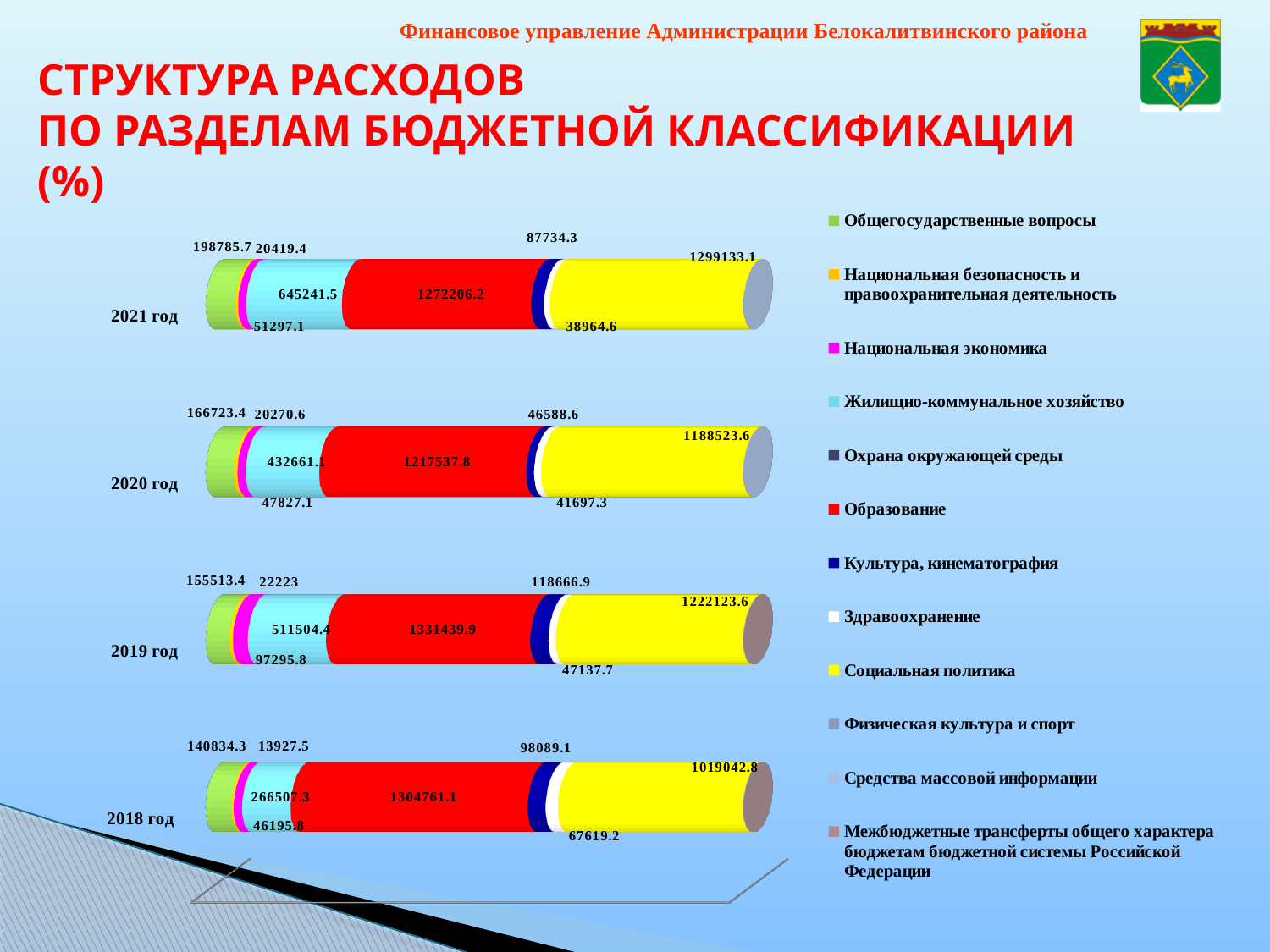
In which year is the Жилищно-коммунальное хозяйство (light blue) segment the lowest? 2018 год What is the value of the Жилищно-коммунальное хозяйство (light blue) segment for 2018 год? 266507.3 What is the value of the Образование (red) segment for 2021 год? 1272206.2 In which year is the Образование (red) segment the highest? 2019 год What is the value of the Образование (red) segment for 2018 год? 1304761.1 How many years (bars) are shown in the chart? 4 Which year has the larger Образование value, 2019 год or 2020 год? 2019 год What kind of chart is shown on the slide? Stacked bar chart How many series does the legend list? 12 What colour represents Образование in the legend? Red What is the value of the Жилищно-коммунальное хозяйство (light blue) segment for 2021 год? 645241.5 By how much does the Жилищно-коммунальное хозяйство value for 2021 год exceed that for 2020 год? 212580.4